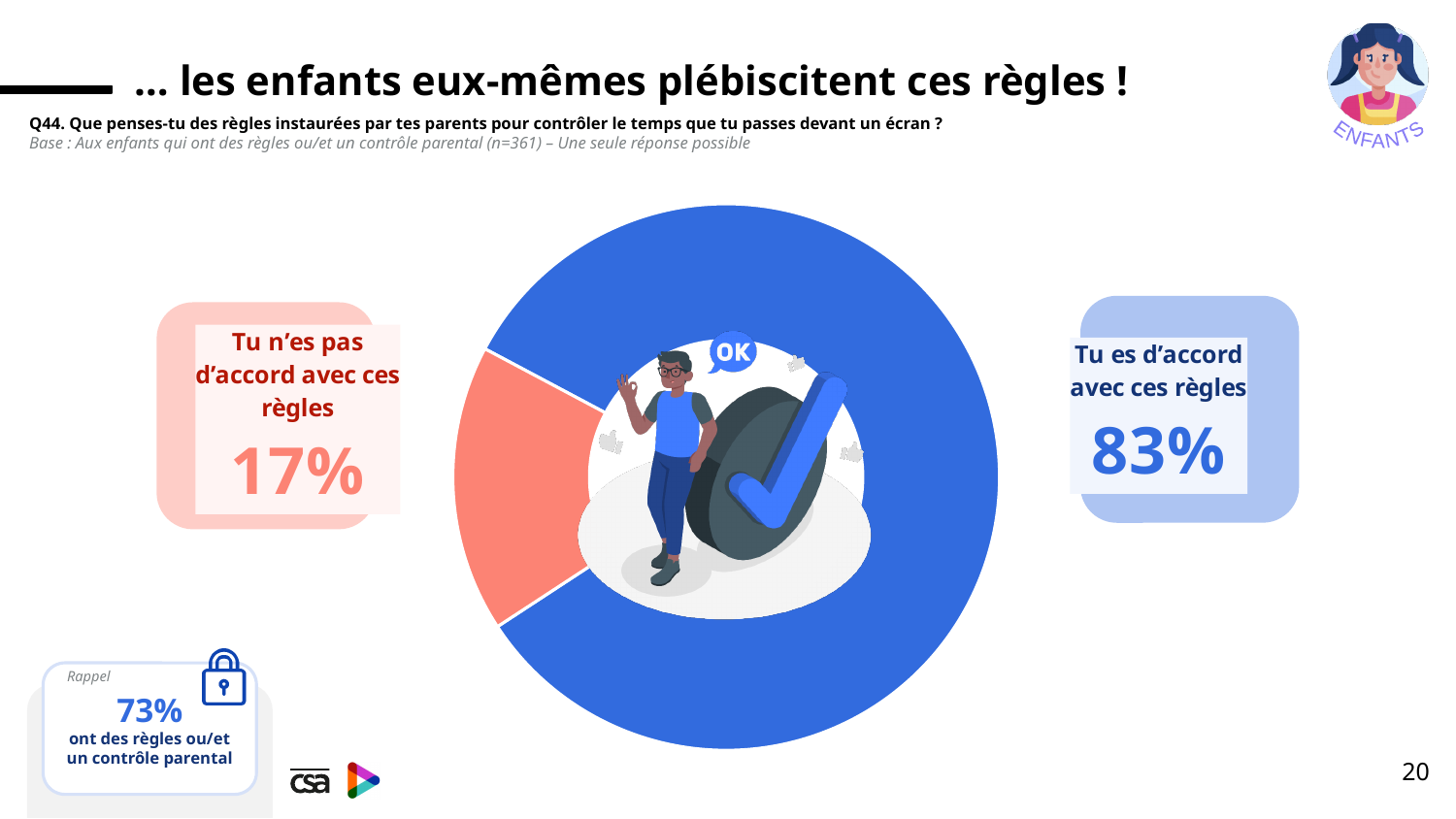
What is the difference in percentage points between the share who agree with the rules and the share who do not? 66 What kind of chart is shown on the slide? Doughnut chart What share of children answered "Tu es d'accord avec ces règles"? 83% How many slices does the pie chart have? 2 What colour is the slice for "Tu n'es pas d'accord avec ces règles"? Red Which is larger: the share who agree with the rules or the share who do not agree? The share who agree (83%) Which response has the largest slice of the pie chart? Tu es d'accord avec ces règles What colour is the slice for "Tu es d'accord avec ces règles"? Blue What share of children answered "Tu n'es pas d'accord avec ces règles"? 17% Which response has the smallest slice of the pie chart? Tu n'es pas d'accord avec ces règles What is the sample size (n) stated in the base of the chart? 361